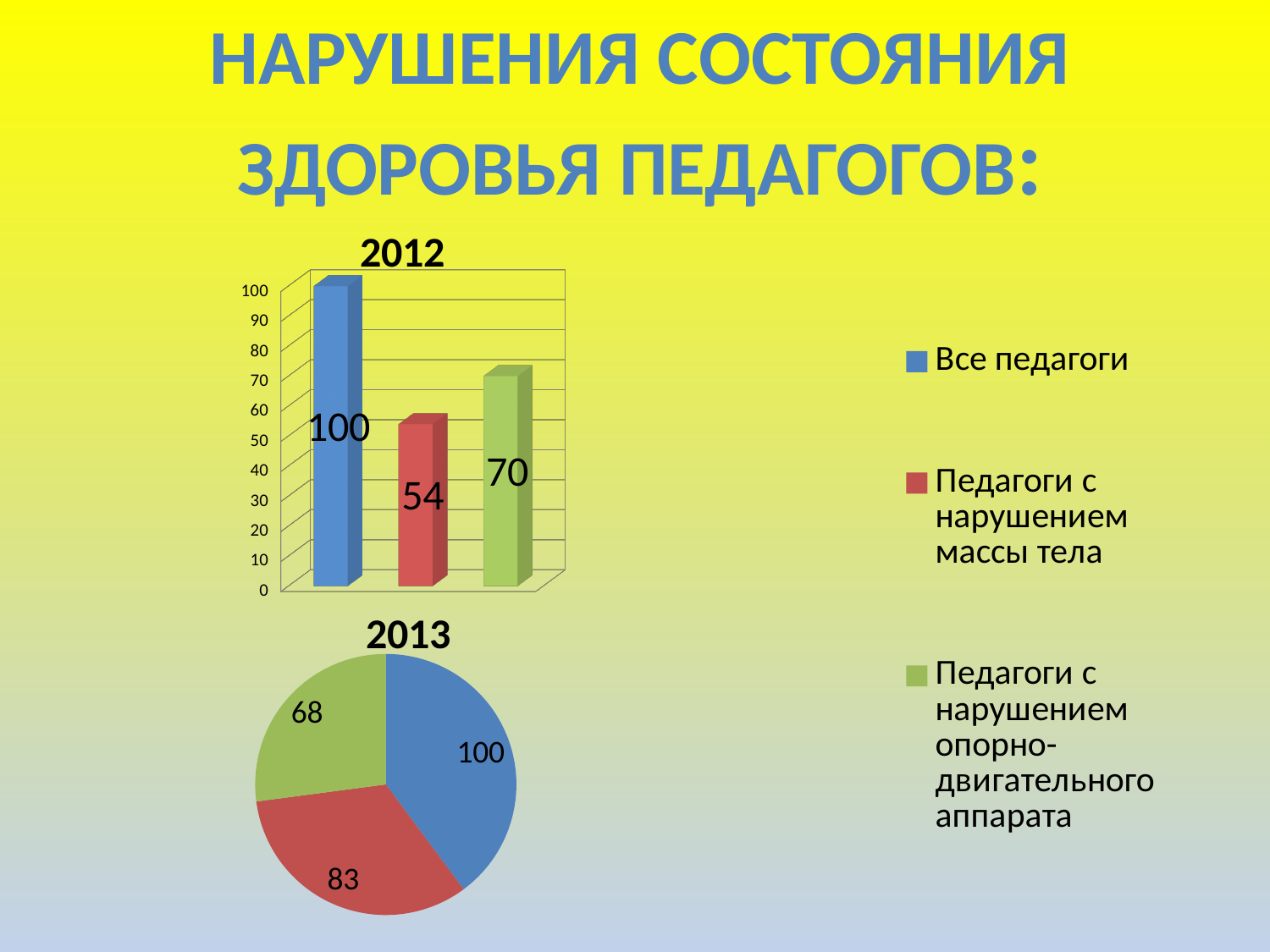
In the 2012 chart, what is the value for Все педагоги? 100 In the 2012 chart, what is the value for Педагоги с нарушением опорно-двигательного аппарата? 70 In the 2013 chart, what is the value for Педагоги с нарушением опорно-двигательного аппарата? 68 In the 2012 chart, what is the value for Педагоги с нарушением массы тела? 54 What kind of chart is the 2012 chart? Bar chart In the 2013 chart, which is larger: the value for Педагоги с нарушением массы тела or the value for Педагоги с нарушением опорно-двигательного аппарата? Педагоги с нарушением массы тела How many entries does the legend list? 3 In the 2012 chart, which category has the lowest value? Педагоги с нарушением массы тела In the 2012 chart, what is the difference between the values for Все педагоги and Педагоги с нарушением массы тела? 46 In the 2013 chart, what is the value for Педагоги с нарушением массы тела? 83 In the 2012 chart, how many bars are plotted? 3 What kind of chart is the 2013 chart? Pie chart